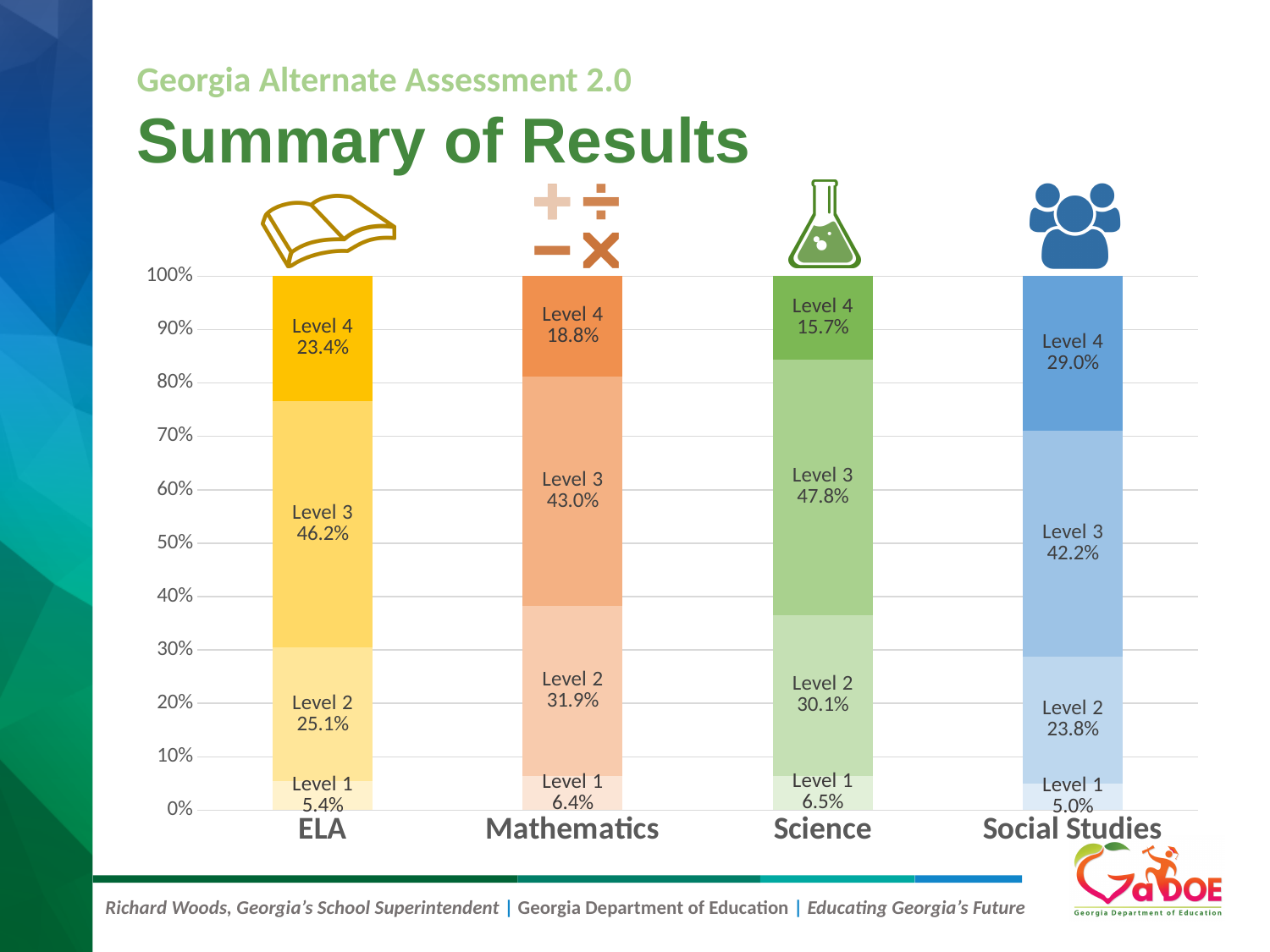
What percentage of Mathematics students scored at Level 1? 6.4% What is the difference between the Level 3 percentages for Science and Social Studies? 5.6 percentage points Which subject has the highest Level 4 percentage? Social Studies What is the Level 4 percentage for Social Studies? 29.0% What percentage of ELA students scored at Level 3? 46.2% Which has a larger Level 2 percentage, Mathematics or Science? Mathematics Which subject has the lowest Level 1 percentage? Social Studies What is the difference between the Level 4 percentages for ELA and Mathematics? 4.6 percentage points What kind of chart is shown on the slide? Stacked bar chart Which subject has the highest Level 3 percentage? Science What is the Level 2 percentage for Science? 30.1% How many subjects are shown on the chart? 4